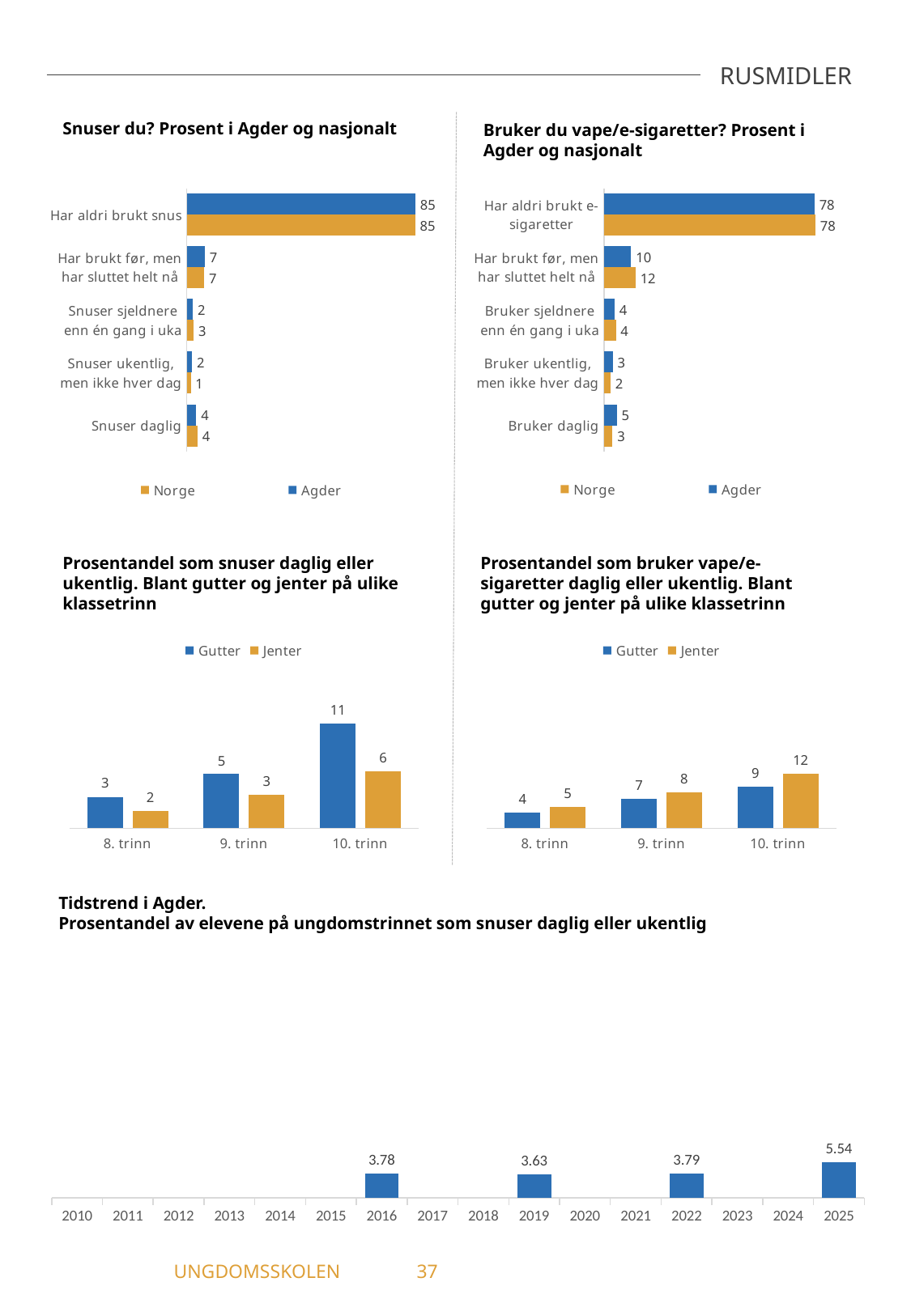
In the chart 'Snuser du? Prosent i Agder og nasjonalt', what is the value for Agder for 'Har aldri brukt snus'? 85 In the chart 'Prosentandel som snuser daglig eller ukentlig. Blant gutter og jenter på ulike klassetrinn', what is the difference between Gutter and Jenter at 10. trinn? 5 In the chart 'Bruker du vape/e-sigaretter? Prosent i Agder og nasjonalt', which is larger for 'Bruker daglig', Agder or Norge? Agder In the chart 'Prosentandel som snuser daglig eller ukentlig. Blant gutter og jenter på ulike klassetrinn', what is the value for Gutter at 10. trinn? 11 In the chart 'Tidstrend i Agder', which year has the lowest value? 2019 In the chart 'Tidstrend i Agder', what is the value for 2025? 5.54 How many series does the legend list in the chart 'Snuser du? Prosent i Agder og nasjonalt'? 2 In the chart 'Prosentandel som bruker vape/e-sigaretter daglig eller ukentlig. Blant gutter og jenter på ulike klassetrinn', which class level has the highest value for Jenter? 10. trinn In the chart 'Prosentandel som bruker vape/e-sigaretter daglig eller ukentlig. Blant gutter og jenter på ulike klassetrinn', do the Gutter values rise or fall from 8. trinn to 10. trinn? rise In the chart 'Bruker du vape/e-sigaretter? Prosent i Agder og nasjonalt', what is the Norge value for 'Har brukt før, men har sluttet helt nå'? 12 In the chart 'Bruker du vape/e-sigaretter? Prosent i Agder og nasjonalt', what is the difference between the Agder and Norge values for 'Bruker daglig'? 2 In the chart 'Snuser du? Prosent i Agder og nasjonalt', what is the Norge value for 'Snuser sjeldnere enn én gang i uka'? 3